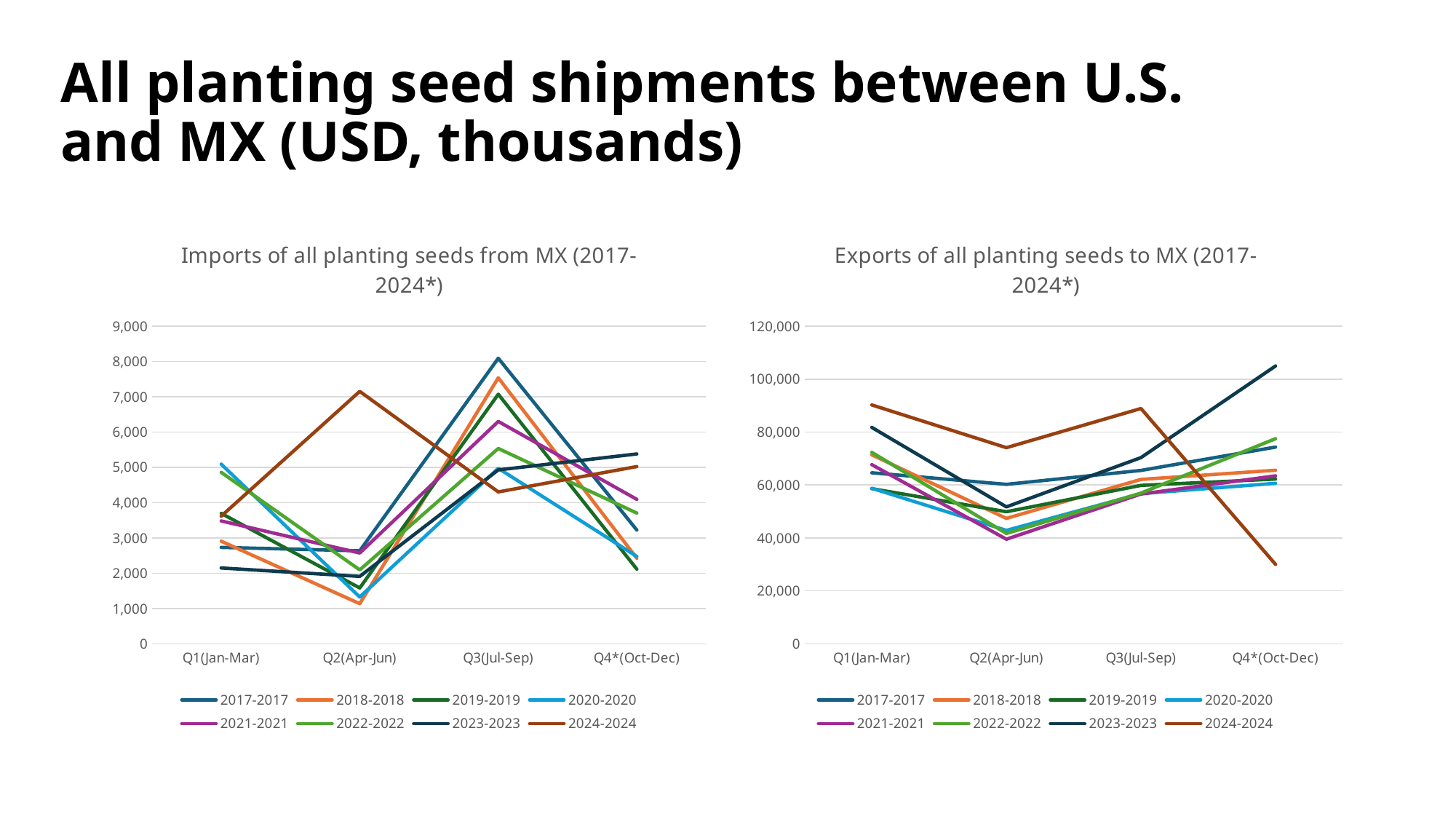
In the 'Imports of all planting seeds from MX (2017-2024*)' chart, in which quarter does the 2024-2024 series reach its highest value? Q2(Apr-Jun) How many quarters are shown on the x axis of the 'Imports of all planting seeds from MX (2017-2024*)' chart? 4 In the 'Exports of all planting seeds to MX (2017-2024*)' chart, is the value for 2024-2024 at Q1(Jan-Mar) greater or less than 80,000? greater In the 'Exports of all planting seeds to MX (2017-2024*)' chart, does the 2024-2024 series rise or fall from Q3(Jul-Sep) to Q4*(Oct-Dec)? fall In the 'Imports of all planting seeds from MX (2017-2024*)' chart, is the value for 2023-2023 at Q1(Jan-Mar) greater or less than 3,000? less What kind of chart is the 'Imports of all planting seeds from MX (2017-2024*)' chart? line chart How many series does the legend of the 'Exports of all planting seeds to MX (2017-2024*)' chart list? 8 In the 'Exports of all planting seeds to MX (2017-2024*)' chart, which series has the highest value at Q4*(Oct-Dec)? 2023-2023 In the 'Exports of all planting seeds to MX (2017-2024*)' chart, is the value for 2024-2024 at Q4*(Oct-Dec) greater or less than 40,000? less In the 'Imports of all planting seeds from MX (2017-2024*)' chart, which series is higher at Q3(Jul-Sep): 2017-2017 or 2019-2019? 2017-2017 What is the title of the chart on the right side of the slide? Exports of all planting seeds to MX (2017-2024*)